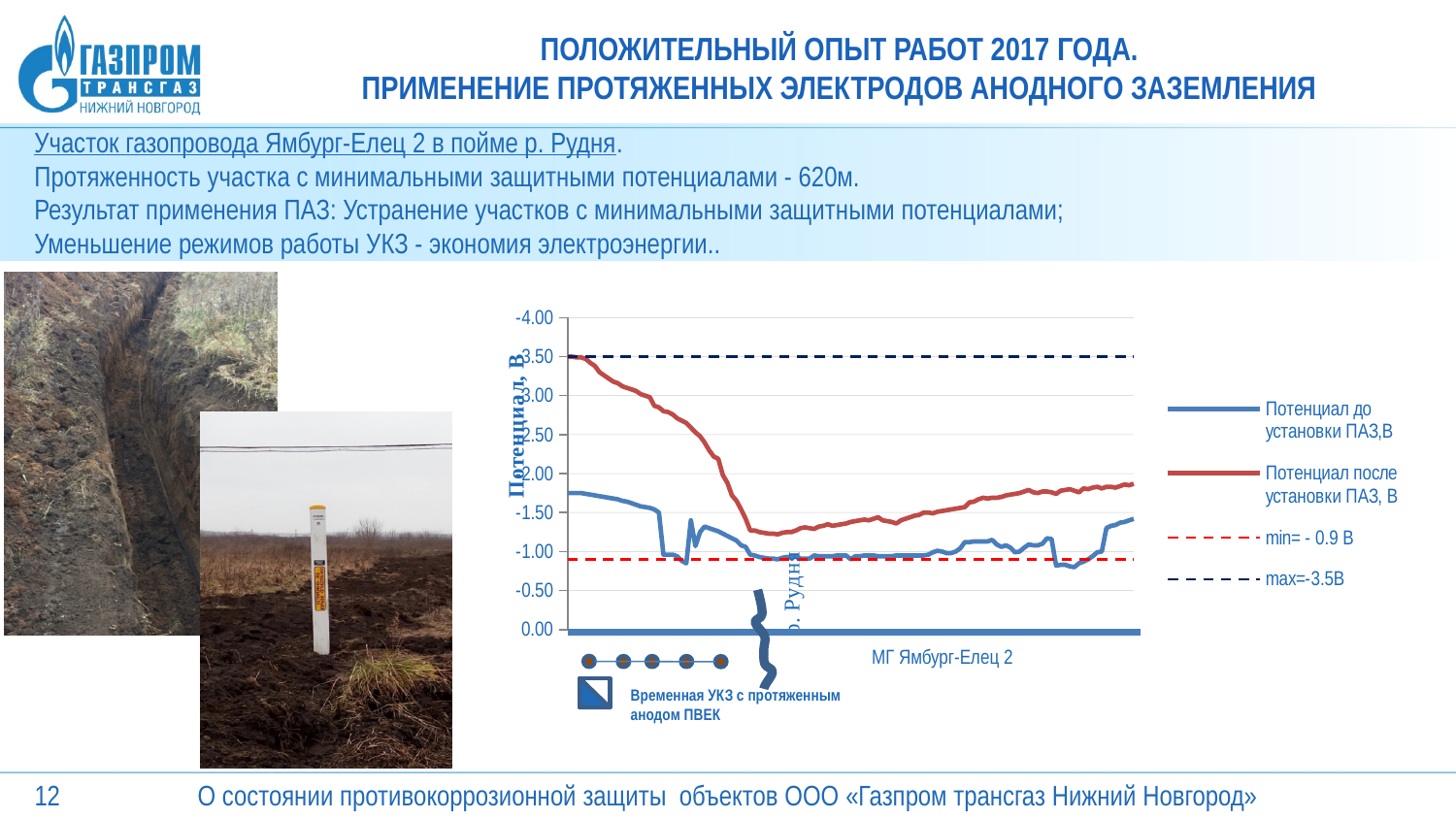
How many entries does the chart legend list? 4 At the right edge of the chart, is the value of the series "Потенциал после установки ПАЗ, В" greater or less than -3.00? greater What kind of chart is shown on the slide? line chart At the left edge of the chart, which series has the more negative potential: "Потенциал до установки ПАЗ,В" or "Потенциал после установки ПАЗ, В"? Потенциал после установки ПАЗ, В Which legend entry corresponds to the solid red line? Потенциал после установки ПАЗ, В At the left edge of the chart, is the value of the series "Потенциал до установки ПАЗ,В" greater or less than -2.00? greater What is the value of the dashed reference line labelled "max" in the chart legend? -3.5В At the left edge of the chart, is the value of the series "Потенциал после установки ПАЗ, В" greater or less than -3.00? less What is the title of the vertical axis of the chart? Потенциал, В What is the topmost tick value shown on the vertical axis of the chart? -4.00 What is the value of the dashed reference line labelled "min" in the chart legend? - 0.9 В Moving from left to right along the x axis, does the red series "Потенциал после установки ПАЗ, В" move toward -4.00 or toward 0.00? toward 0.00